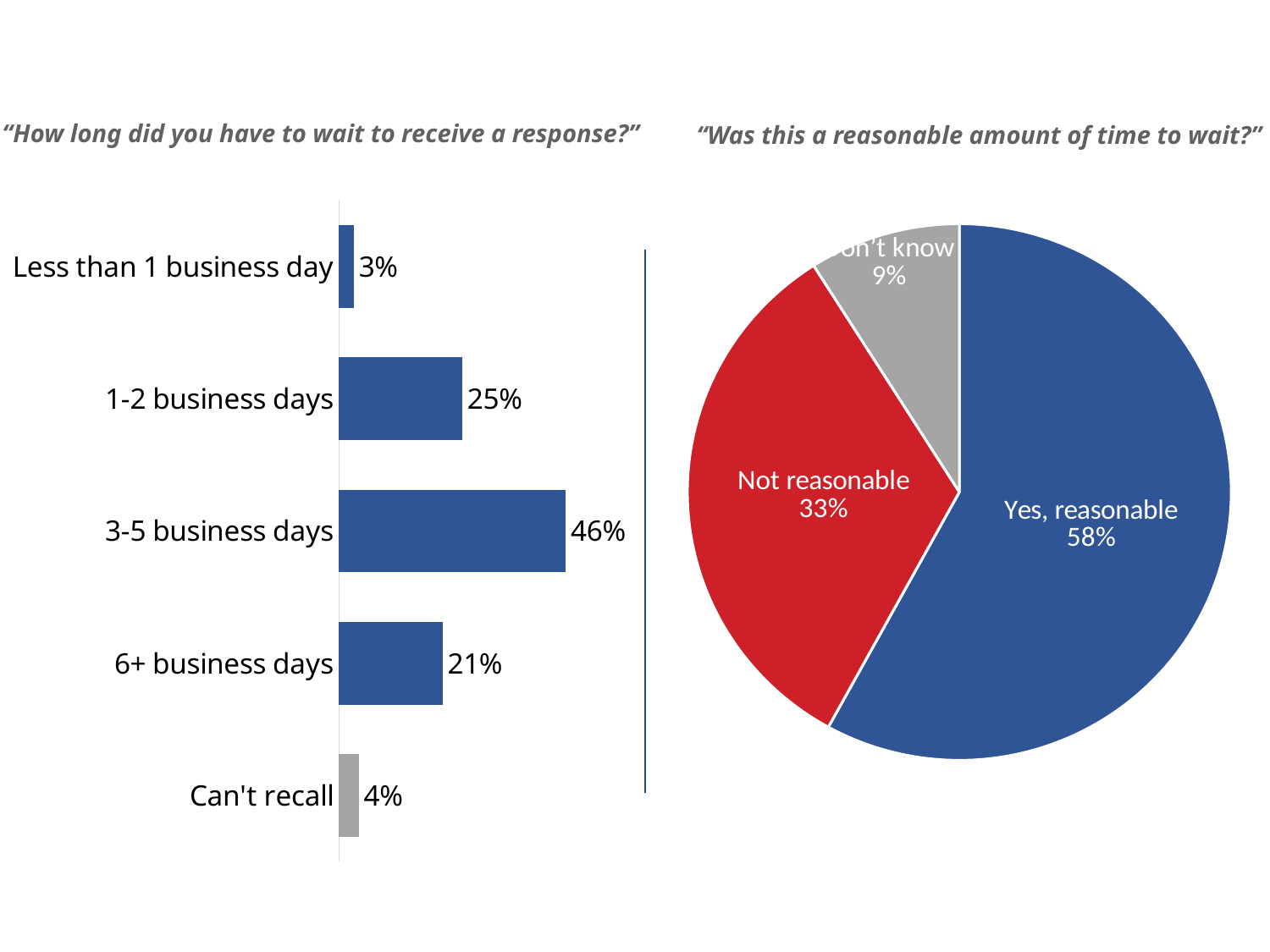
In the bar chart "How long did you have to wait to receive a response?", which category has the highest value? 3-5 business days In the bar chart "How long did you have to wait to receive a response?", which category has the lowest value? Less than 1 business day How many categories are shown in the bar chart "How long did you have to wait to receive a response?"? 5 In the pie chart "Was this a reasonable amount of time to wait?", what is the difference between the Yes, reasonable and Not reasonable shares? 25% In the pie chart "Was this a reasonable amount of time to wait?", which slice is the largest? Yes, reasonable In the bar chart "How long did you have to wait to receive a response?", what is the value for 3-5 business days? 46% In the pie chart "Was this a reasonable amount of time to wait?", what share is Not reasonable? 33% In the bar chart "How long did you have to wait to receive a response?", which is larger: the value for 6+ business days or the value for Can't recall? 6+ business days What kind of chart is the chart on the right, "Was this a reasonable amount of time to wait?"? Pie chart In the bar chart "How long did you have to wait to receive a response?", what is the value for 1-2 business days? 25% What kind of chart is the chart on the left, "How long did you have to wait to receive a response?"? Bar chart In the bar chart "How long did you have to wait to receive a response?", what is the difference between the values for 1-2 business days and 6+ business days? 4%